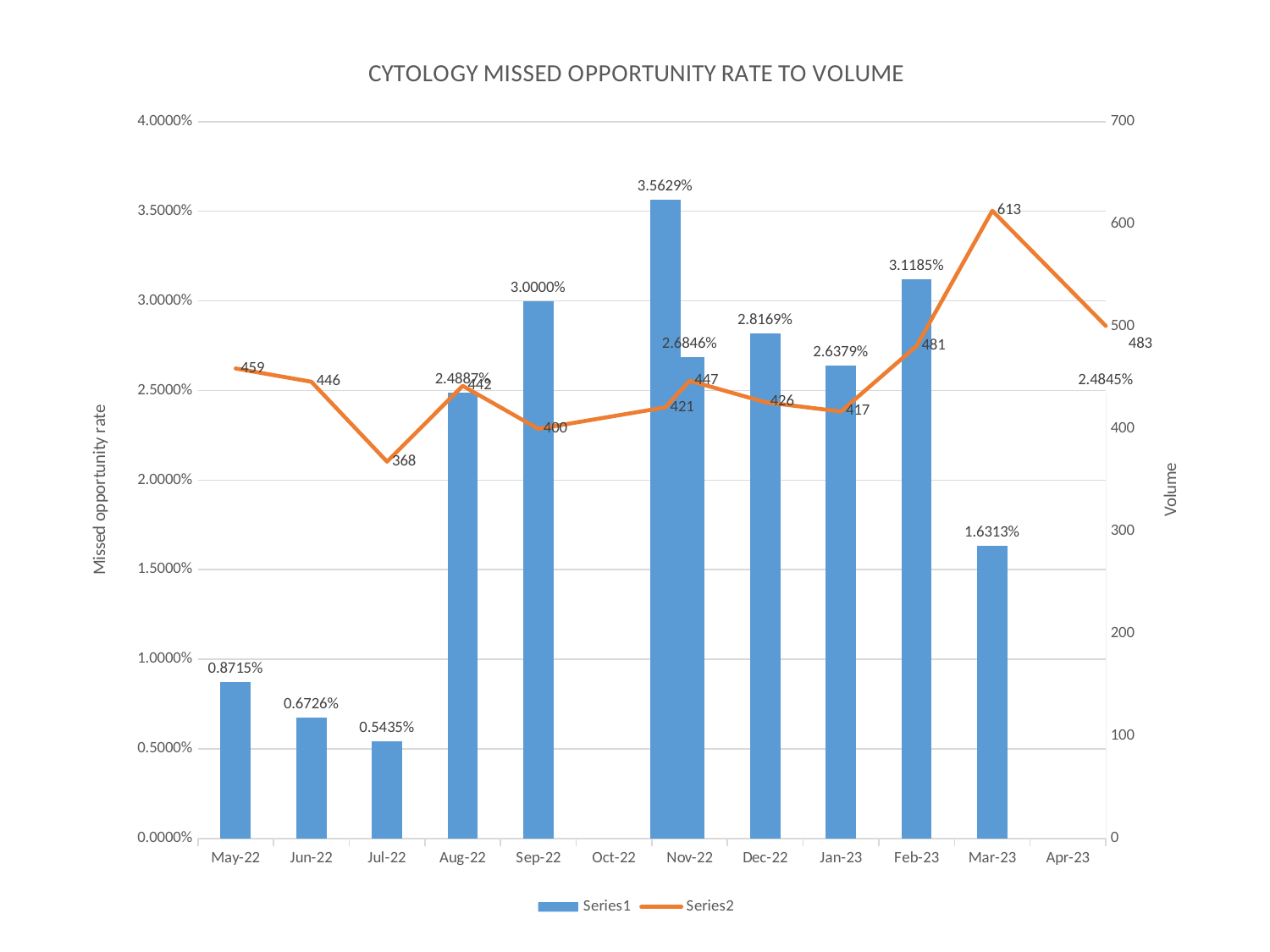
What kind of chart is shown on the slide? Combination bar and line chart What is the volume value shown for Jul-22? 368 Which has the higher missed opportunity rate, Dec-22 or Jan-23? Dec-22 Which month has the lowest volume on the line? Jul-22 What is the volume value shown for Mar-23? 613 How many series does the legend list? 2 Does the missed opportunity rate rise or fall from May-22 to Jul-22? Fall What is the missed opportunity rate for Jul-22? 0.5435% What is the difference in volume between Mar-23 and Feb-23? 132